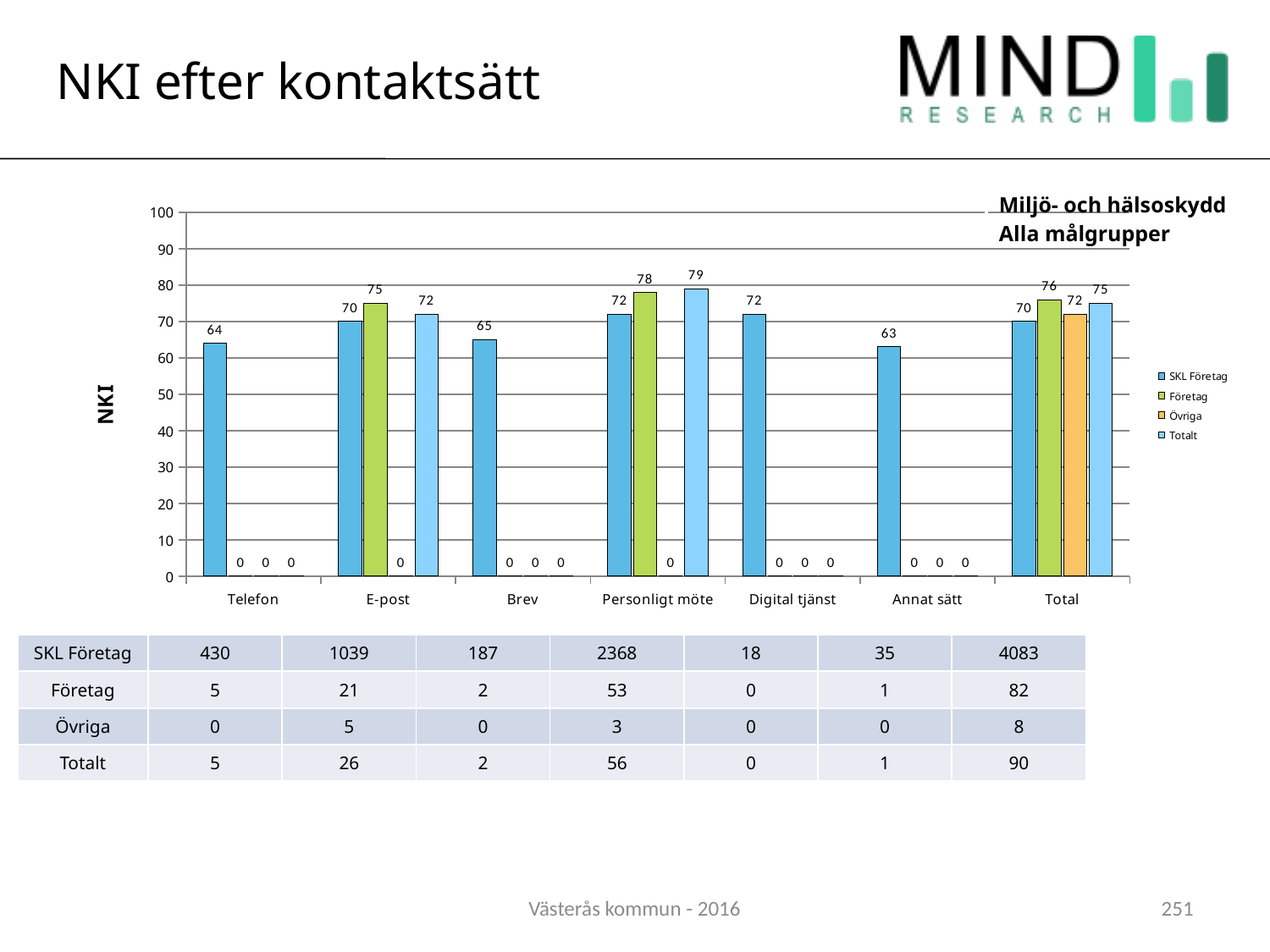
What kind of chart is shown on the slide? Bar chart How many categories are shown on the x axis of the chart? 7 How many series does the chart legend list? 4 What is the NKI value for Övriga in the Total category? 72 What is the difference between the Totalt value for Personligt möte and the Totalt value for E-post? 7 Which category has the highest NKI value for Företag? Personligt möte What is the NKI value for SKL Företag in the Telefon category? 64 Which category has the lowest NKI value for SKL Företag? Annat sätt What is the NKI value for Totalt in the Personligt möte category? 79 Which is larger: the SKL Företag value for Brev or the SKL Företag value for Digital tjänst? Digital tjänst What is the label on the vertical axis of the chart? NKI What is the NKI value for Företag in the E-post category? 75